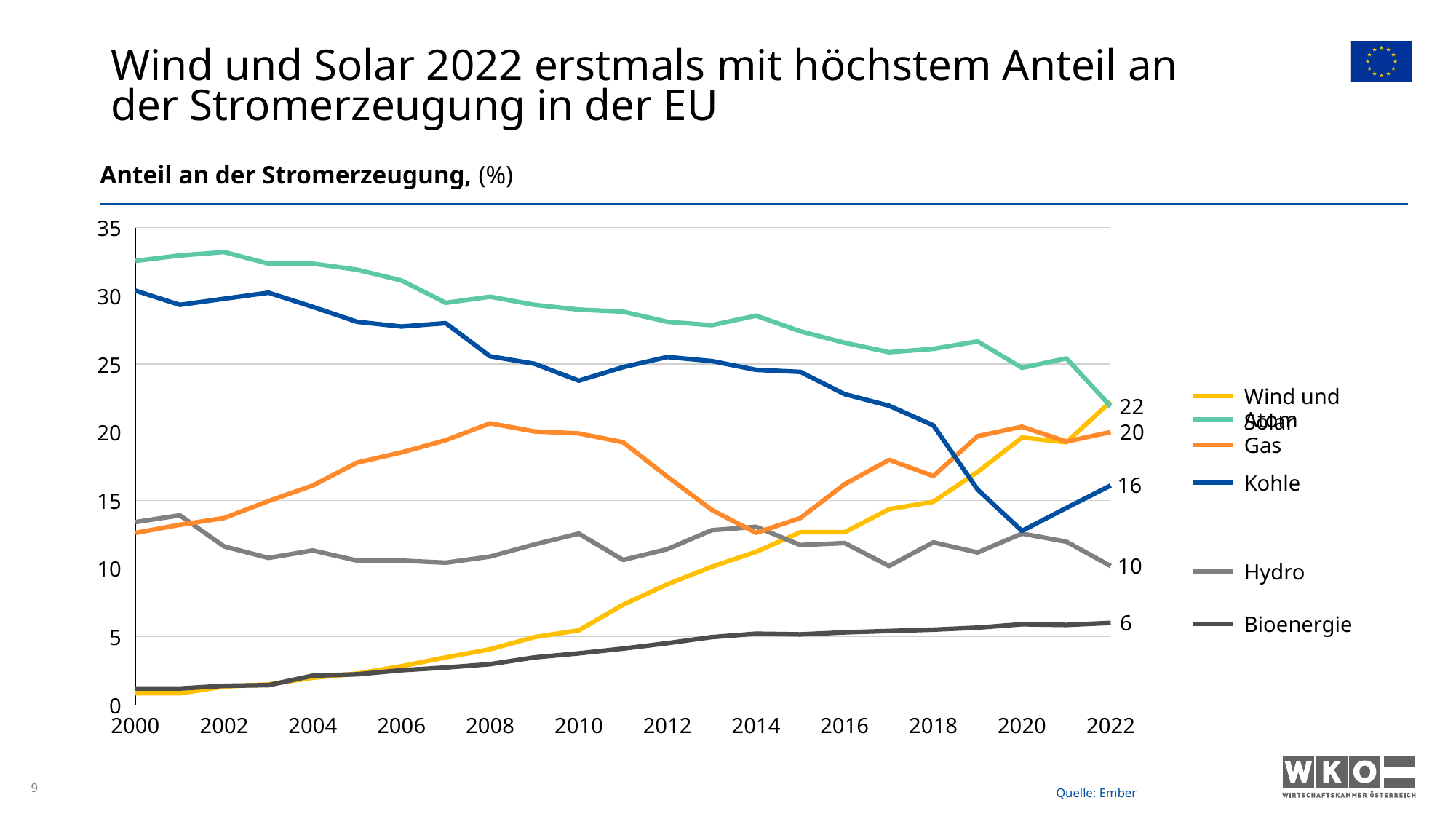
What is the value for Bioenergie in 2022? 6 What is the value for Gas in 2022? 20 What is the difference between the values for Gas and Kohle in 2022? 4 Which series has the lowest value in 2022? Bioenergie Is the value for Atom in 2000 greater or less than 30? greater What kind of chart is shown on the slide? line chart Does the Wind und Solar line rise or fall from 2000 to 2022? rise Does the Kohle line rise or fall from 2000 to 2022? fall Which is larger in 2022, the value for Kohle or the value for Hydro? Kohle What is the value for Hydro in 2022? 10 What is the value for Kohle in 2022? 16 How many series does the legend list? 6